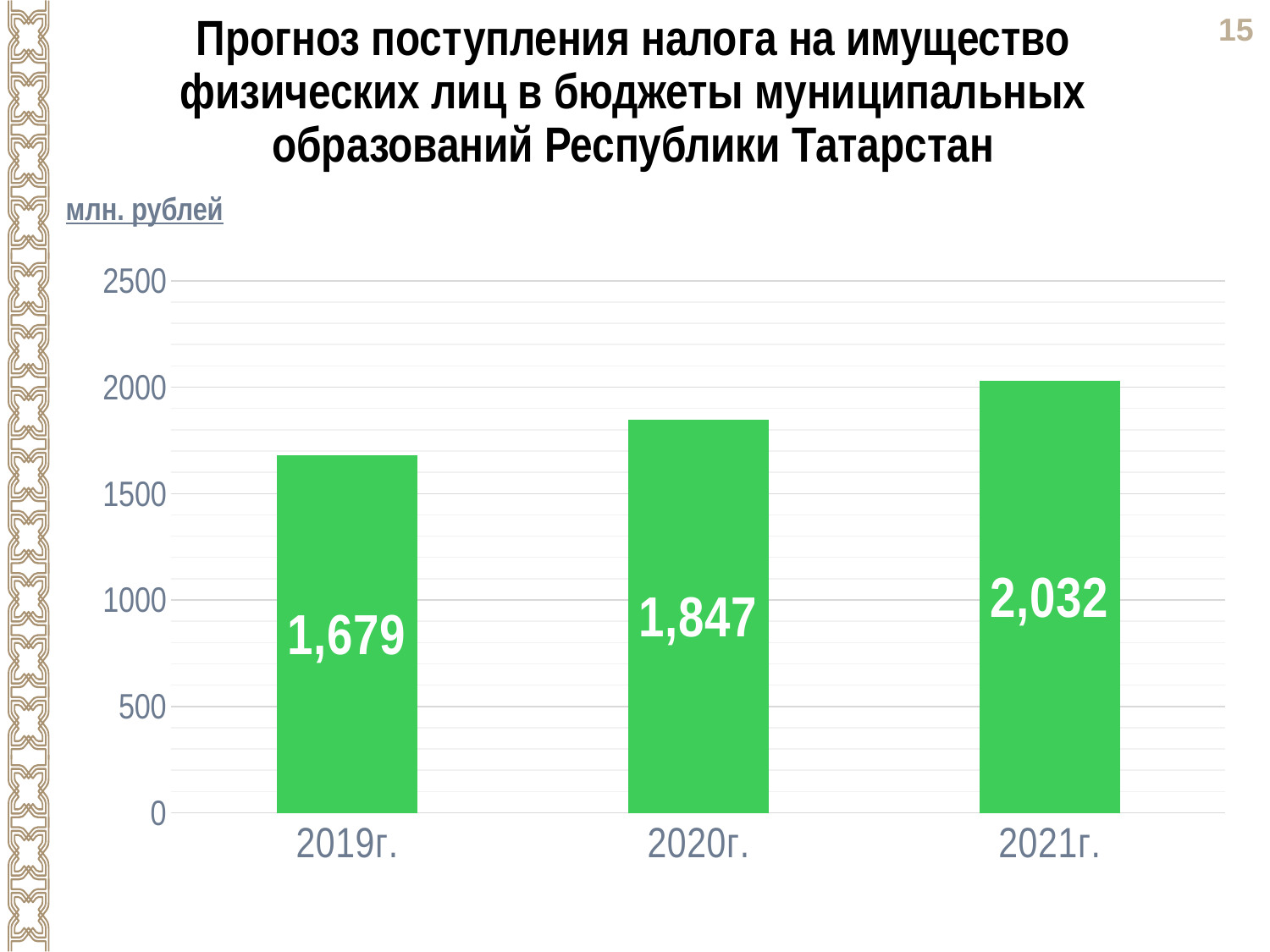
Which is larger, the value for 2020г. or the value for 2021г.? 2021г. What is the value for 2021г.? 2,032 What is the value for 2020г.? 1,847 How many years are shown on the chart? 3 What is the difference between the values for 2020г. and 2019г.? 168 Do the values rise or fall from 2019г. to 2021г.? rise What kind of chart is shown on the slide? bar chart What is the difference between the values for 2021г. and 2019г.? 353 Which year has the highest value? 2021г. Is the value for 2021г. greater or less than 2000? greater Which year has the lowest value? 2019г. What is the value for 2019г.? 1,679